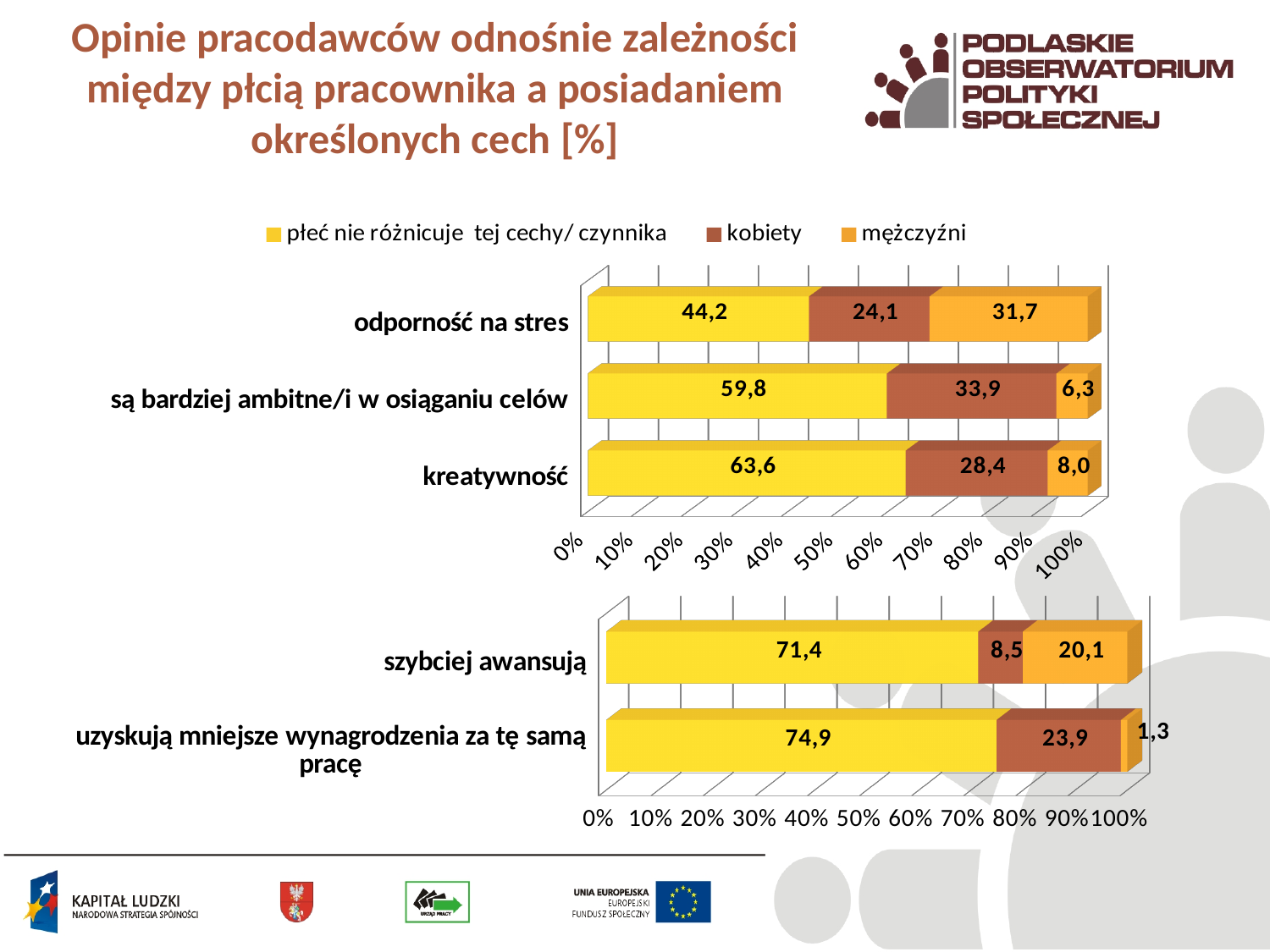
What type of chart is the lower chart? stacked bar chart In the upper chart, which category has the lowest value for 'płeć nie różnicuje tej cechy/ czynnika'? odporność na stres In the upper chart, what is the difference between the 'kobiety' values for 'są bardziej ambitne/i w osiąganiu celów' and 'kreatywność'? 5,5 How many series does the legend list? 3 In the upper chart, what is the value for 'płeć nie różnicuje tej cechy/ czynnika' for 'kreatywność'? 63,6 In the lower chart, what is the value for 'kobiety' for 'uzyskują mniejsze wynagrodzenia za tę samą pracę'? 23,9 How many categories are shown in the upper chart? 3 In the upper chart, which category has the highest value for 'mężczyźni'? odporność na stres In the upper chart, what is the value for 'kobiety' for 'odporność na stres'? 24,1 In the lower chart, what is the value for 'mężczyźni' for 'szybciej awansują'? 20,1 In the lower chart, what is the total of the stacked bar for 'szybciej awansują'? 100 In the lower chart, which is larger: the 'kobiety' value for 'szybciej awansują' or for 'uzyskują mniejsze wynagrodzenia za tę samą pracę'? uzyskują mniejsze wynagrodzenia za tę samą pracę